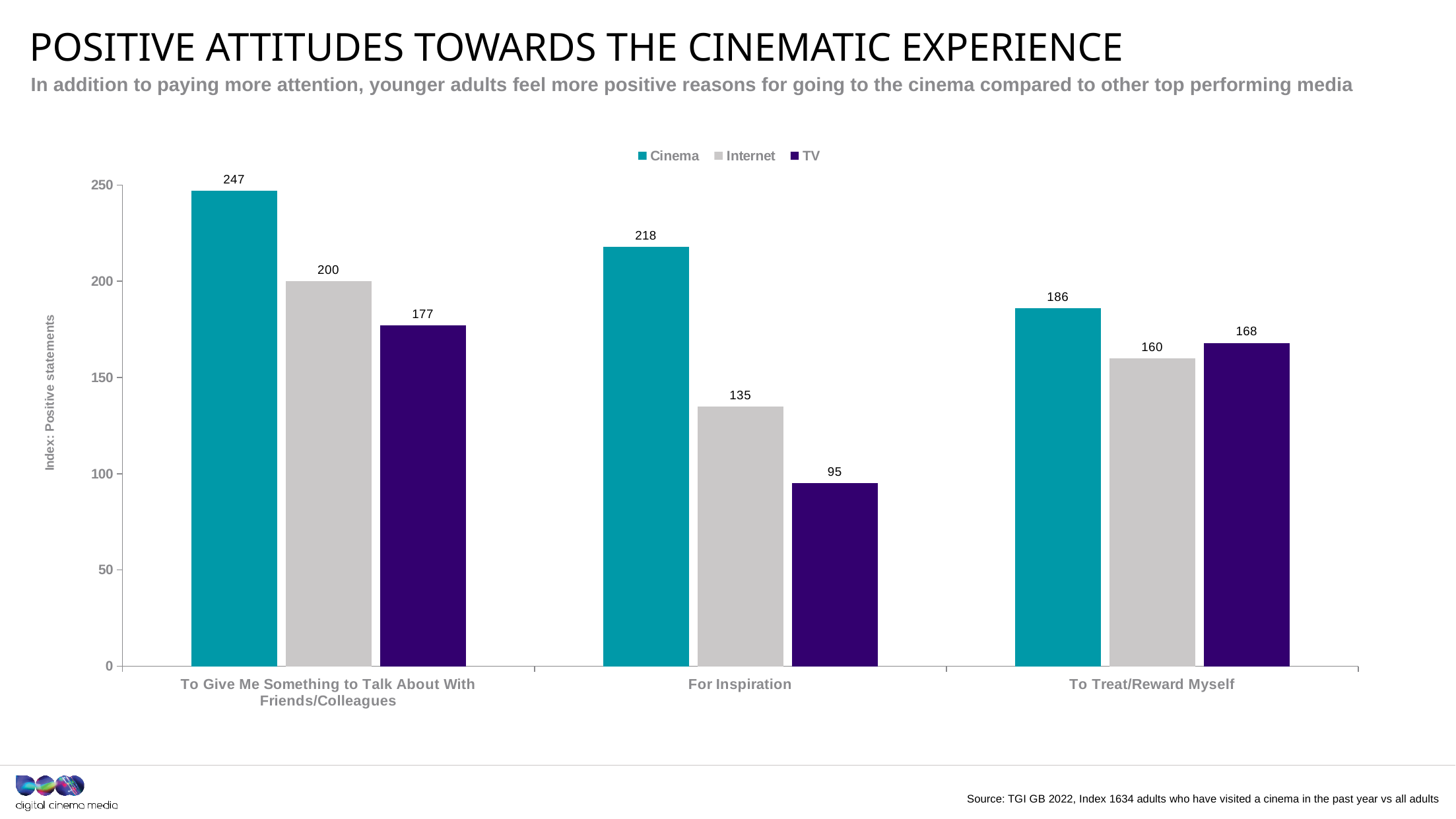
What is the difference between the Cinema and Internet values for 'For Inspiration'? 83 Which category has the lowest TV value? For Inspiration What is the Internet value for 'To Treat/Reward Myself'? 160 Is the Internet value for 'For Inspiration' greater or less than 150? less Which category has the highest Cinema value? To Give Me Something to Talk About With Friends/Colleagues What is the label of the y axis? Index: Positive statements What kind of chart is shown on the slide? Bar chart What is the TV value for 'For Inspiration'? 95 For 'To Treat/Reward Myself', which is larger: the Internet value or the TV value? TV What is the Cinema value for 'To Give Me Something to Talk About With Friends/Colleagues'? 247 How many series does the legend list? 3 How many categories are shown on the x axis? 3